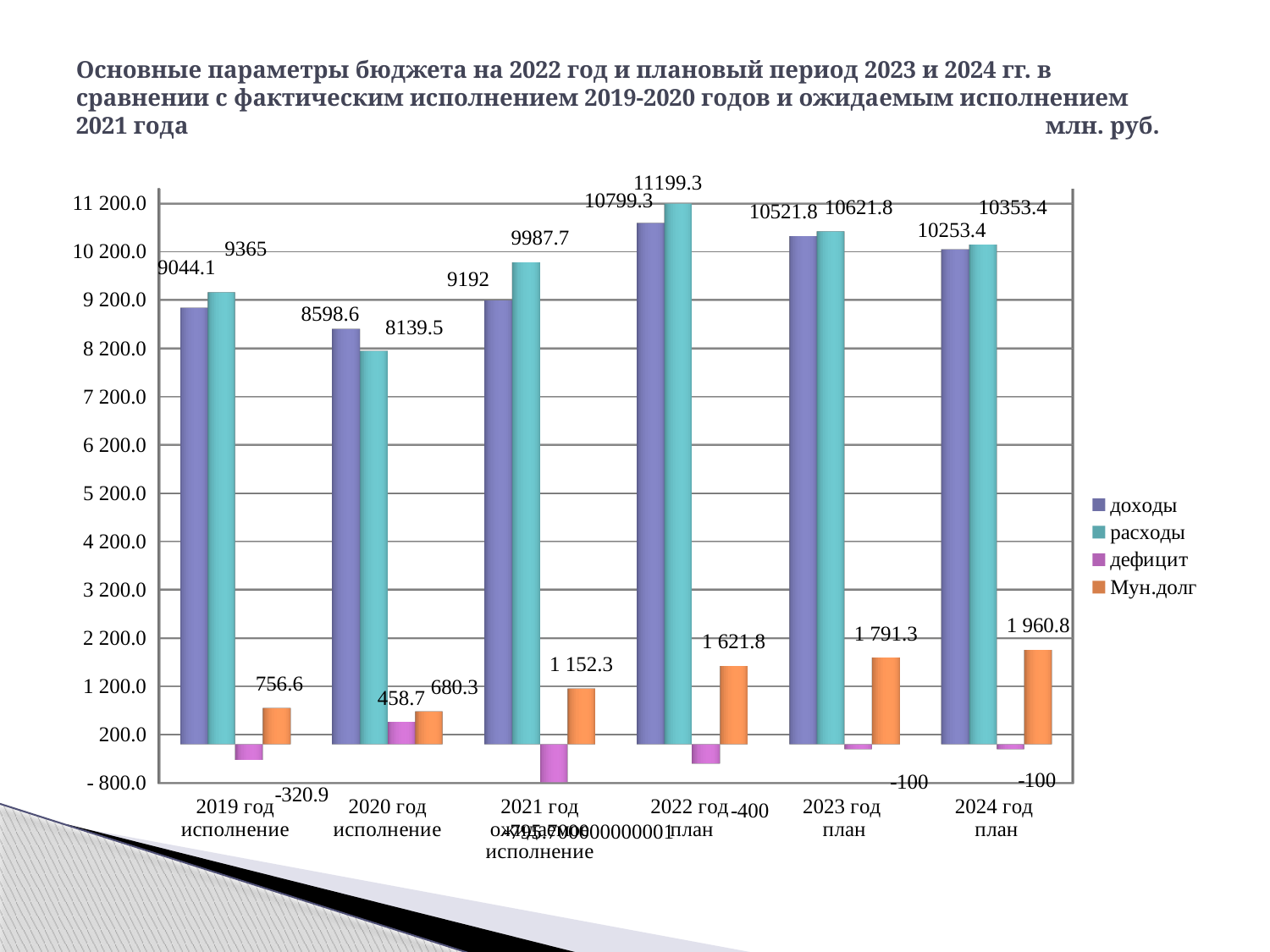
Does the value of Мун.долг rise or fall from 2021 год to 2024 год? rises Which category has the highest value of расходы? 2022 год план Which category has the lowest value of доходы? 2020 год исполнение What is the value of дефицит for 2020 год исполнение? 458.7 By how much do расходы exceed доходы for 2023 год план? 100 How many series does the legend list? 4 For 2020 год исполнение, which is larger: доходы or расходы? доходы What is the value of Мун.долг for 2024 год план? 1 960.8 What is the value of доходы for 2022 год план? 10799.3 What kind of chart is shown on the slide? bar chart By how much do расходы exceed доходы for 2022 год план? 400 How many categories are shown on the x axis? 6